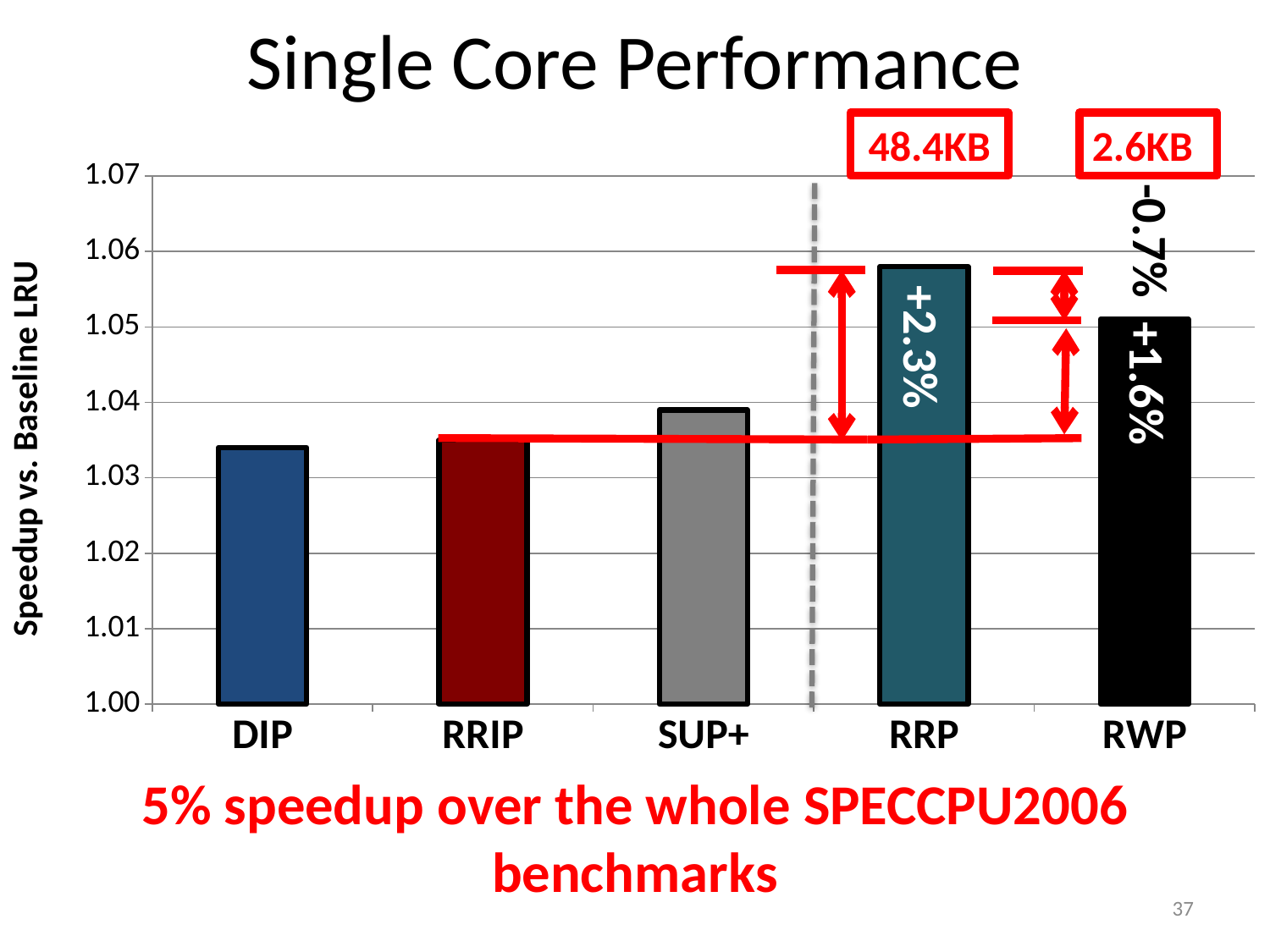
Which is larger, the value for RRP or the value for RWP? RRP Is the value for RRP greater or less than 1.05? greater What kind of chart is shown on the slide? bar chart Is the value for RWP greater or less than 1.04? greater How many categories are plotted on the x axis? 5 Which category has the highest speedup vs. baseline LRU? RRP Is the value for DIP greater or less than 1.04? less What is the label on the y axis? Speedup vs. Baseline LRU Which is larger, the value for SUP+ or the value for DIP? SUP+ What storage size is annotated in the red box above the RRP bar? 48.4KB